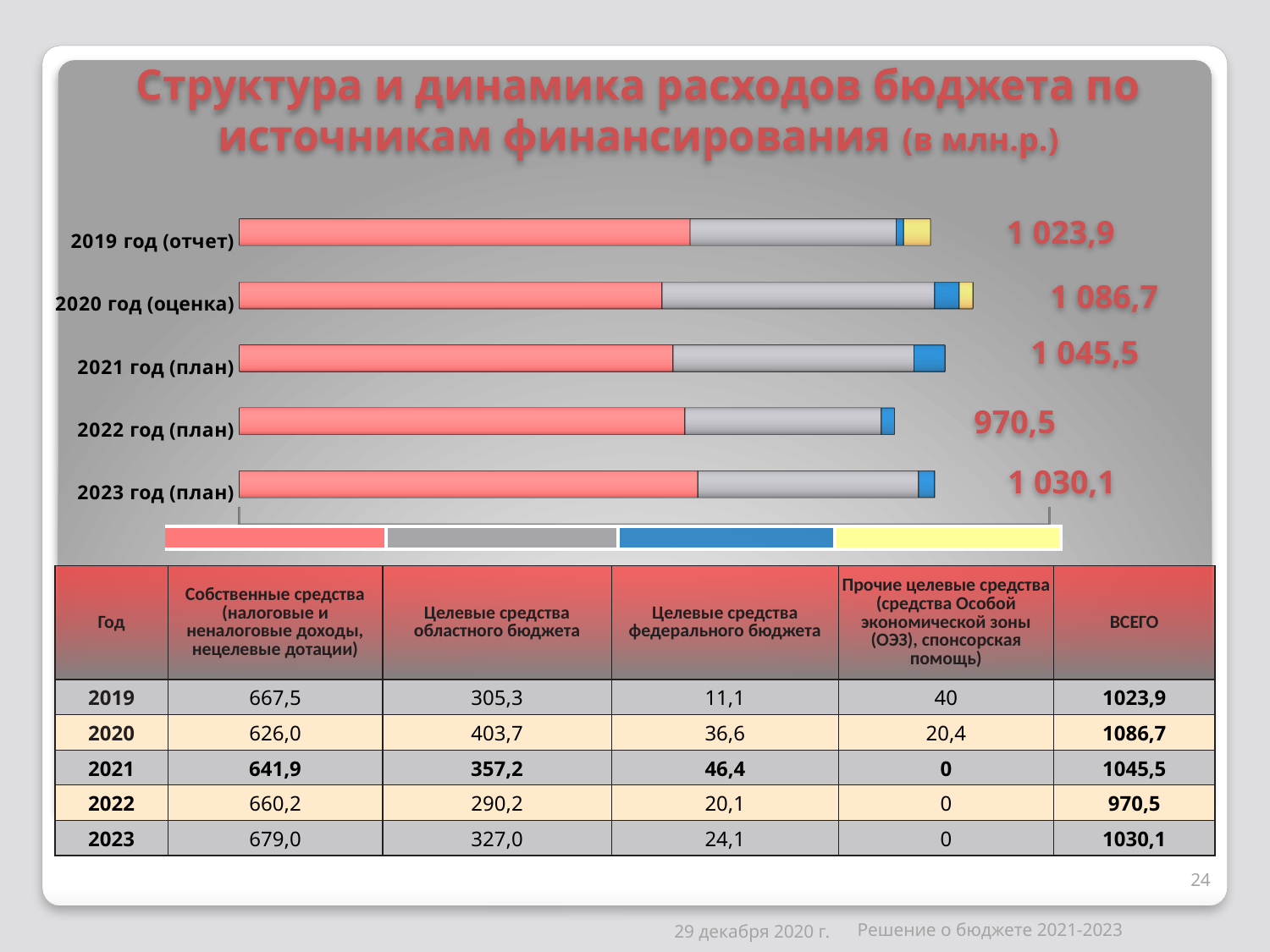
How many colour series does the legend below the chart show? 4 What type of chart is used on this slide? Stacked bar chart What is the difference between the totals for 2021 год (план) and 2023 год (план)? 15,4 What total is shown next to the bar for 2022 год (план)? 970,5 Which year has the lowest total expenditure in the chart? 2022 год (план) Which total is larger, 2019 год (отчет) or 2023 год (план)? 2023 год (план) How many years (bars) are shown in the chart? 5 Which year has the highest total expenditure in the chart? 2020 год (оценка) Does the total expenditure rise or fall from 2021 год (план) to 2022 год (план)? Fall What is the difference between the totals for 2020 год (оценка) and 2022 год (план)? 116,2 What is the total budget expenditure shown for 2019 год (отчет)? 1 023,9 What is the total value labelled for 2020 год (оценка)? 1 086,7